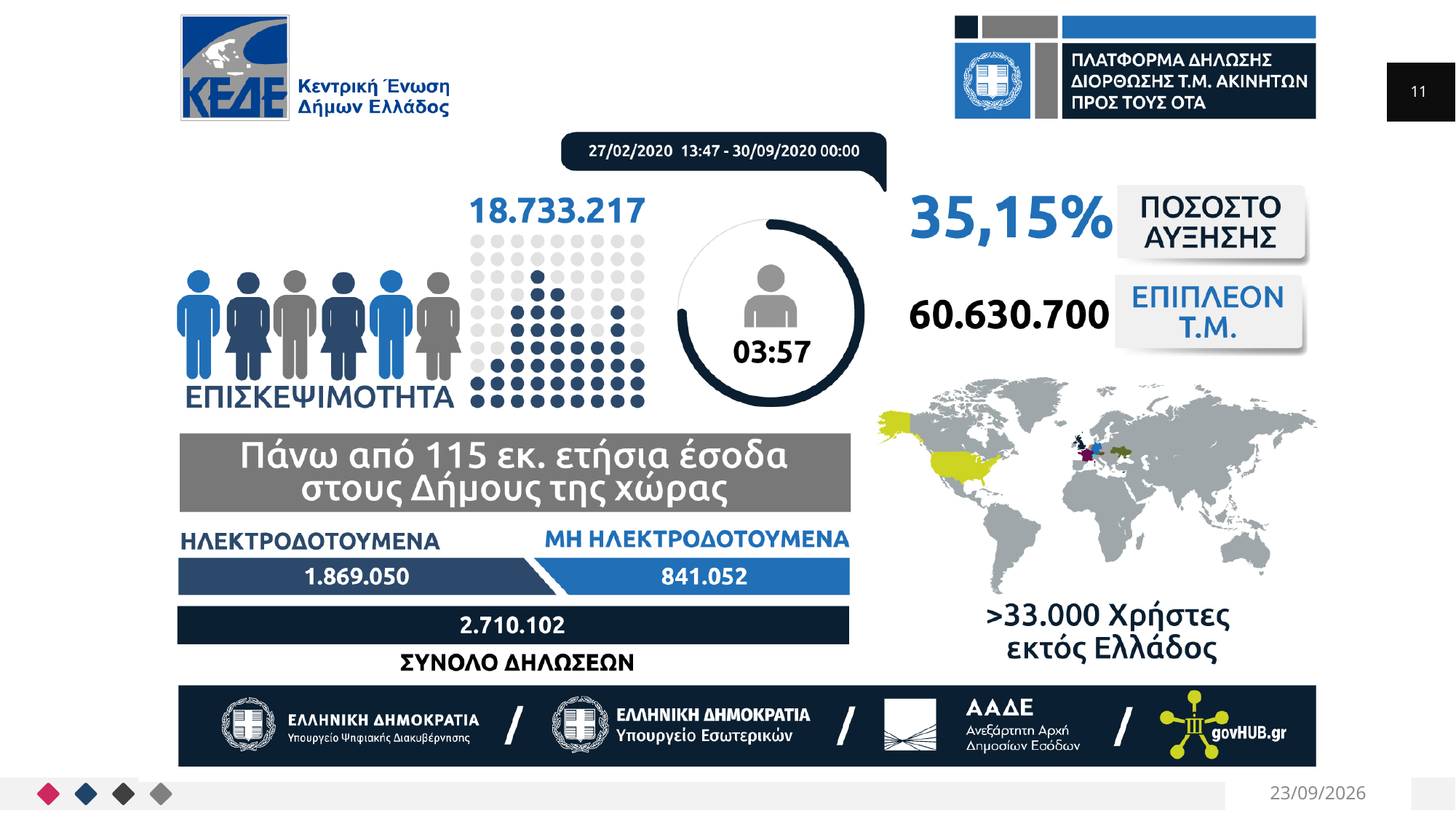
What value is shown for ΕΠΙΠΛΕΟΝ Τ.Μ. on the slide? 60.630.700 What is the value shown for ΕΠΙΣΚΕΨΙΜΟΤΗΤΑ (visits) on the slide? 18.733.217 What is the ΣΥΝΟΛΟ ΔΗΛΩΣΕΩΝ (total declarations) shown on the slide? 2.710.102 What is the difference between ΗΛΕΚΤΡΟΔΟΤΟΥΜΕΝΑ and ΜΗ ΗΛΕΚΤΡΟΔΟΤΟΥΜΕΝΑ in the declarations bar? 1.027.998 What ΠΟΣΟΣΤΟ ΑΥΞΗΣΗΣ (percentage increase) is shown on the slide? 35,15% How many categories are shown in the declarations bar? 2 What time is displayed inside the circular ring graphic? 03:57 In the declarations bar, what is the value for ΗΛΕΚΤΡΟΔΟΤΟΥΜΕΝΑ? 1.869.050 Which is larger in the declarations bar, ΗΛΕΚΤΡΟΔΟΤΟΥΜΕΝΑ or ΜΗ ΗΛΕΚΤΡΟΔΟΤΟΥΜΕΝΑ? ΗΛΕΚΤΡΟΔΟΤΟΥΜΕΝΑ In the declarations bar, what is the value for ΜΗ ΗΛΕΚΤΡΟΔΟΤΟΥΜΕΝΑ? 841.052 How many users outside Greece does the map caption report? >33.000 What date range is shown above the visits graphic? 27/02/2020 13:47 - 30/09/2020 00:00